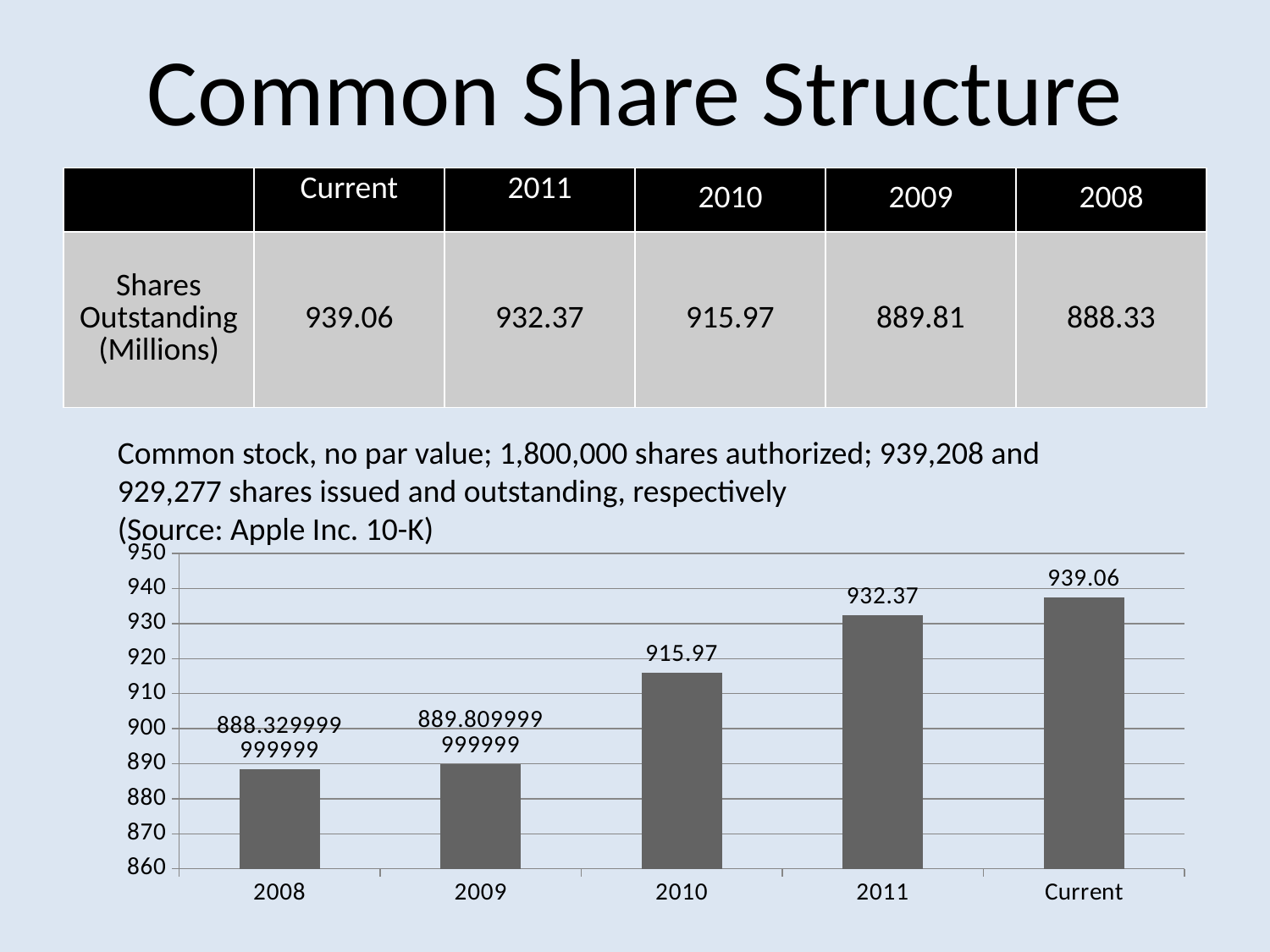
What kind of chart is shown on the slide? bar chart What is the difference between the Current value and the 2011 value? 6.69 Which category has the highest bar? Current Which is larger, the value for 2010 or the value for 2011? 2011 What is the value of the bar for 2010? 915.97 Do the bar values rise or fall from 2008 to Current along the x axis? rise Is the value for 2008 greater or less than 890? less What is the value of the bar for 2011? 932.37 What is the difference between the 2011 value and the 2010 value? 16.40 What is the value of the bar labelled Current? 939.06 How many categories are plotted on the x axis of the chart? 5 Which category has the lowest bar? 2008